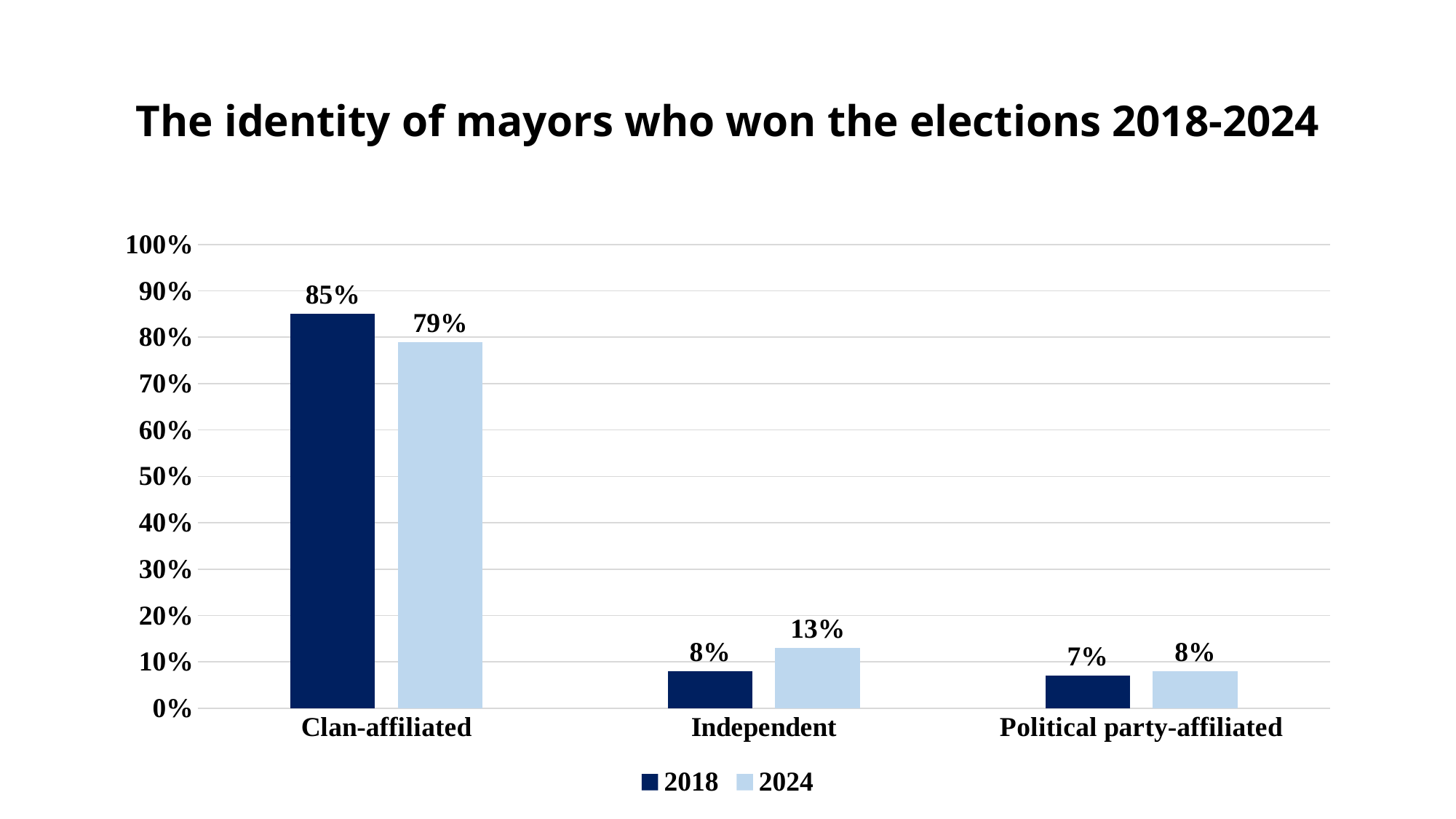
How many series does the legend list? 2 What percentage of mayors who won in 2024 were independent? 13% Which is larger: the 2018 value for independent mayors or the 2024 value for independent mayors? 2024 By how many percentage points did the clan-affiliated share fall from 2018 to 2024? 6 percentage points What is the difference between the 2024 and 2018 values for independent mayors? 5 percentage points What is the title of the chart? The identity of mayors who won the elections 2018-2024 What percentage of mayors who won in 2018 were clan-affiliated? 85% Which category has the lowest value for 2018? Political party-affiliated Which category has the highest value for 2024? Clan-affiliated What kind of chart is shown on the slide? Bar chart How many categories are shown on the x axis? 3 What is the value for political party-affiliated mayors in 2018? 7%